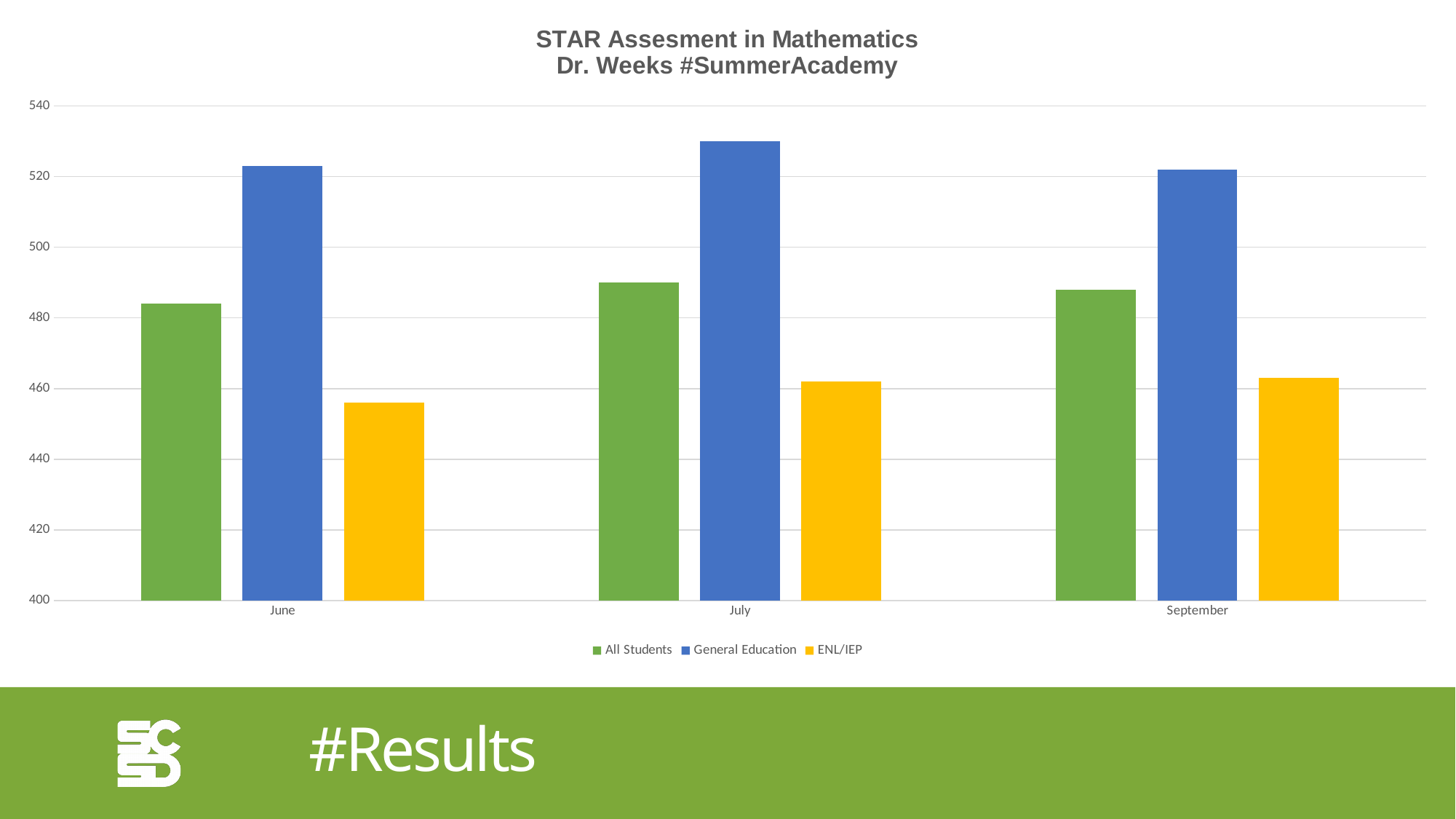
How many months are shown on the x axis? 3 Is the value for General Education in July greater or less than 520? greater In which month is the ENL/IEP value lowest? June Which series has the highest value in every month? General Education Which is larger, the All Students value in June or the All Students value in July? July How many series does the legend list? 3 Is the value for ENL/IEP in June greater or less than 460? less In which month is the General Education value highest? July What colour are the ENL/IEP bars? yellow What kind of chart is shown on the slide? bar chart Which series has the lowest value in every month? ENL/IEP Is the value for All Students in September greater or less than 480? greater